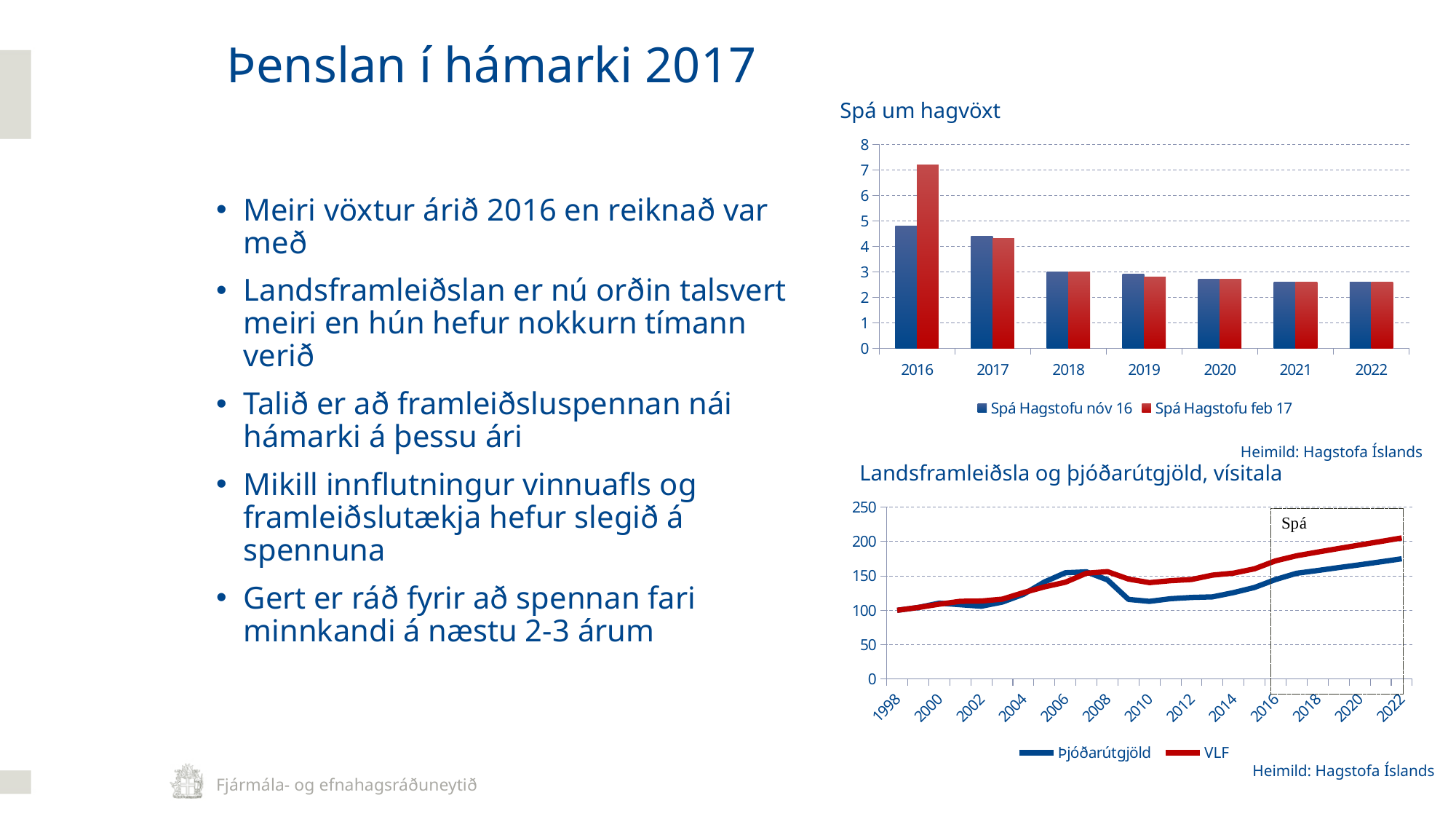
In the 'Landsframleiðsla og þjóðarútgjöld, vísitala' chart, what label appears inside the dashed box on the right side of the plot? Spá In the 'Spá um hagvöxt' chart, do the Spá Hagstofu feb 17 values rise or fall from 2016 to 2022? fall In the 'Spá um hagvöxt' chart, which year has the highest value for Spá Hagstofu feb 17? 2016 In the 'Landsframleiðsla og þjóðarútgjöld, vísitala' chart, which series is higher in 2022: Þjóðarútgjöld or VLF? VLF What kind of chart is the 'Spá um hagvöxt' chart? bar chart In the 'Landsframleiðsla og þjóðarútgjöld, vísitala' chart, is the Þjóðarútgjöld value for 2022 greater or less than 200? less In the 'Spá um hagvöxt' chart, for 2016, which is larger: Spá Hagstofu nóv 16 or Spá Hagstofu feb 17? Spá Hagstofu feb 17 What kind of chart is the 'Landsframleiðsla og þjóðarútgjöld, vísitala' chart? line chart In the 'Spá um hagvöxt' chart, how many years are shown on the x axis? 7 In the 'Spá um hagvöxt' chart, how many series does the legend list? 2 In the 'Spá um hagvöxt' chart, is the Spá Hagstofu nóv 16 value for 2016 greater or less than 4? greater In the 'Spá um hagvöxt' chart, is the Spá Hagstofu feb 17 value for 2016 greater or less than 6? greater